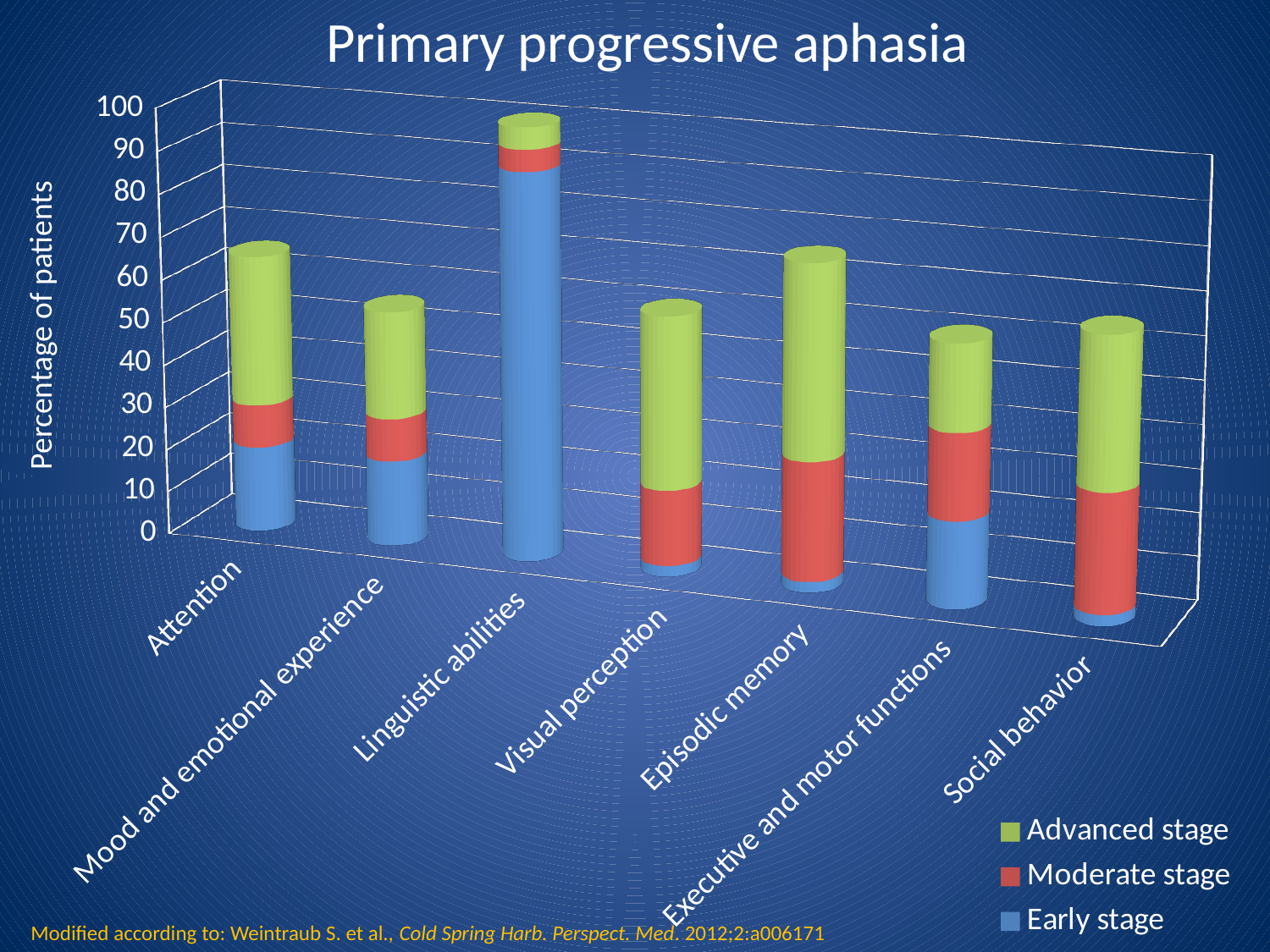
Which category has the largest Early stage segment? Linguistic abilities What type of chart is shown on the slide? Stacked bar chart Which stacked bar is taller, Attention or Mood and emotional experience? Attention What is the label of the vertical axis? Percentage of patients How many series does the legend list? 3 Is the total stacked bar for Mood and emotional experience greater or less than 80? less Is the total stacked bar for Linguistic abilities greater or less than 70? greater Which stacked bar is taller, Episodic memory or Executive and motor functions? Episodic memory Is the total stacked bar for Attention greater or less than 40? greater Which category has the tallest stacked bar? Linguistic abilities How many categories are shown on the x axis of the chart? 7 What is the title of the chart? Primary progressive aphasia